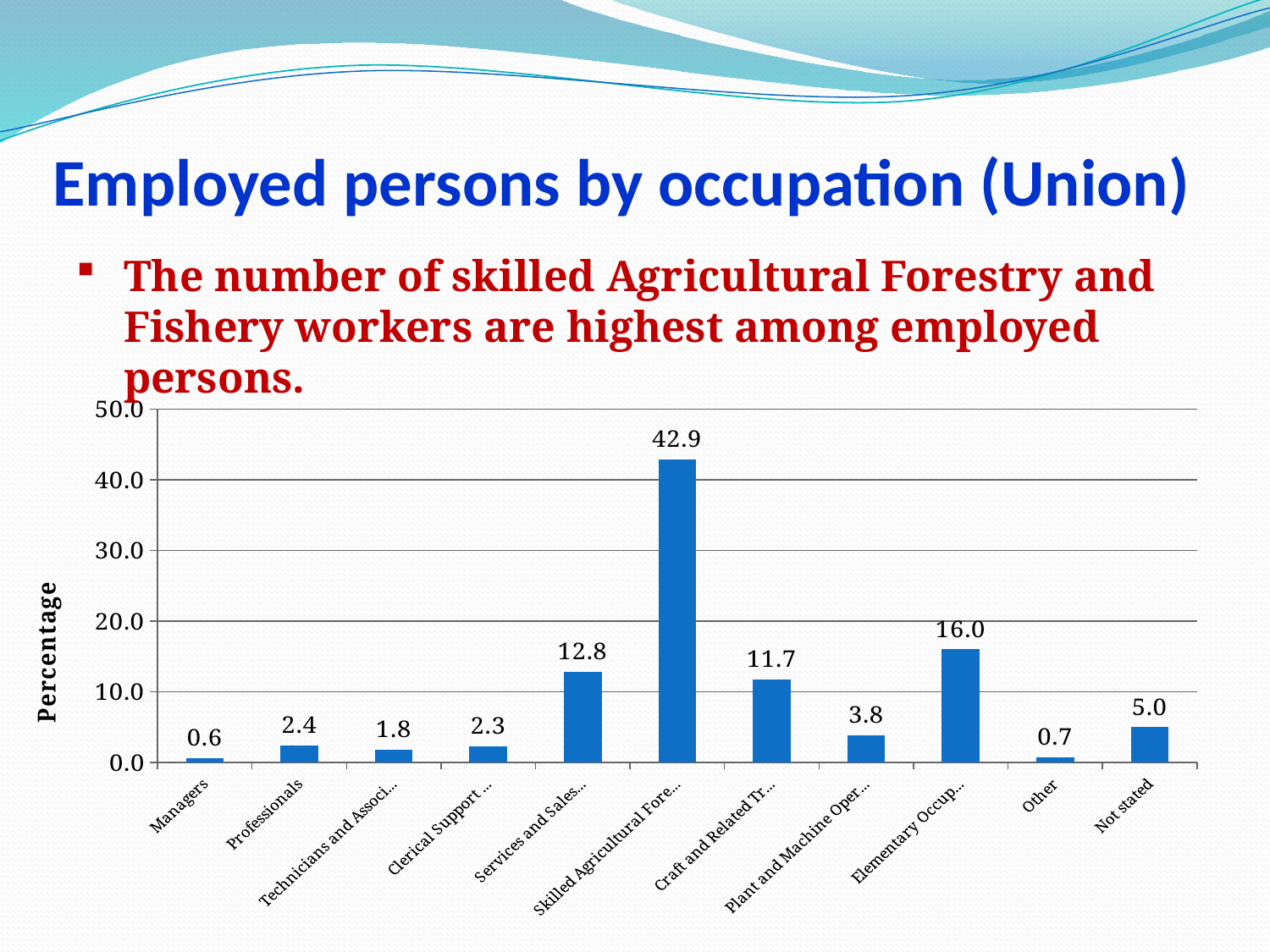
What kind of chart is shown on the slide? bar chart Which category has the lowest value? Managers What is the value for the Other category? 0.7 What is the value for Not stated? 5.0 How many categories are shown on the x axis? 11 Which is larger, the value for Craft and Related Tr... or the value for Services and Sales...? Services and Sales... Is the value for Skilled Agricultural Fore... greater or less than 40.0? greater What is the difference between the values for Elementary Occup... and Services and Sales...? 3.2 What is the value for Managers? 0.6 What is the label of the y axis? Percentage Which category has the highest value? Skilled Agricultural Fore... What is the value for Professionals? 2.4